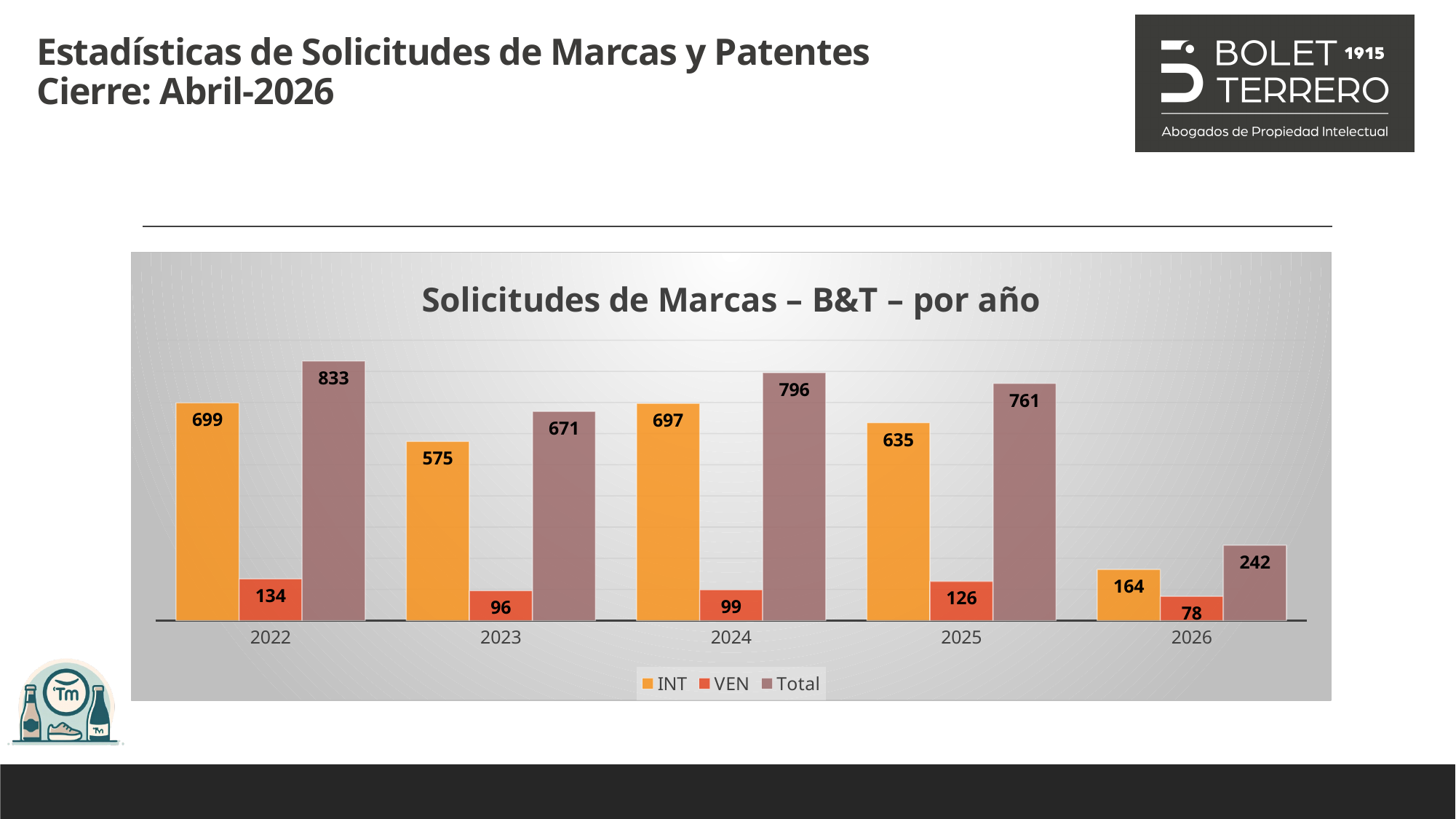
Which is larger, the VEN value for 2022 or the VEN value for 2025? 2022 What is the difference between the Total values for 2024 and 2023? 125 Does the Total value rise or fall from 2025 to 2026? Fall Which year has the lowest INT value? 2026 What is the VEN value for 2023? 96 What is the title of the chart? Solicitudes de Marcas – B&T – por año How many years are shown on the x axis? 5 How many series does the legend list? 3 Which year has the highest Total value? 2022 What is the Total value for 2025? 761 What kind of chart is shown? Bar chart What is the INT value for 2022? 699